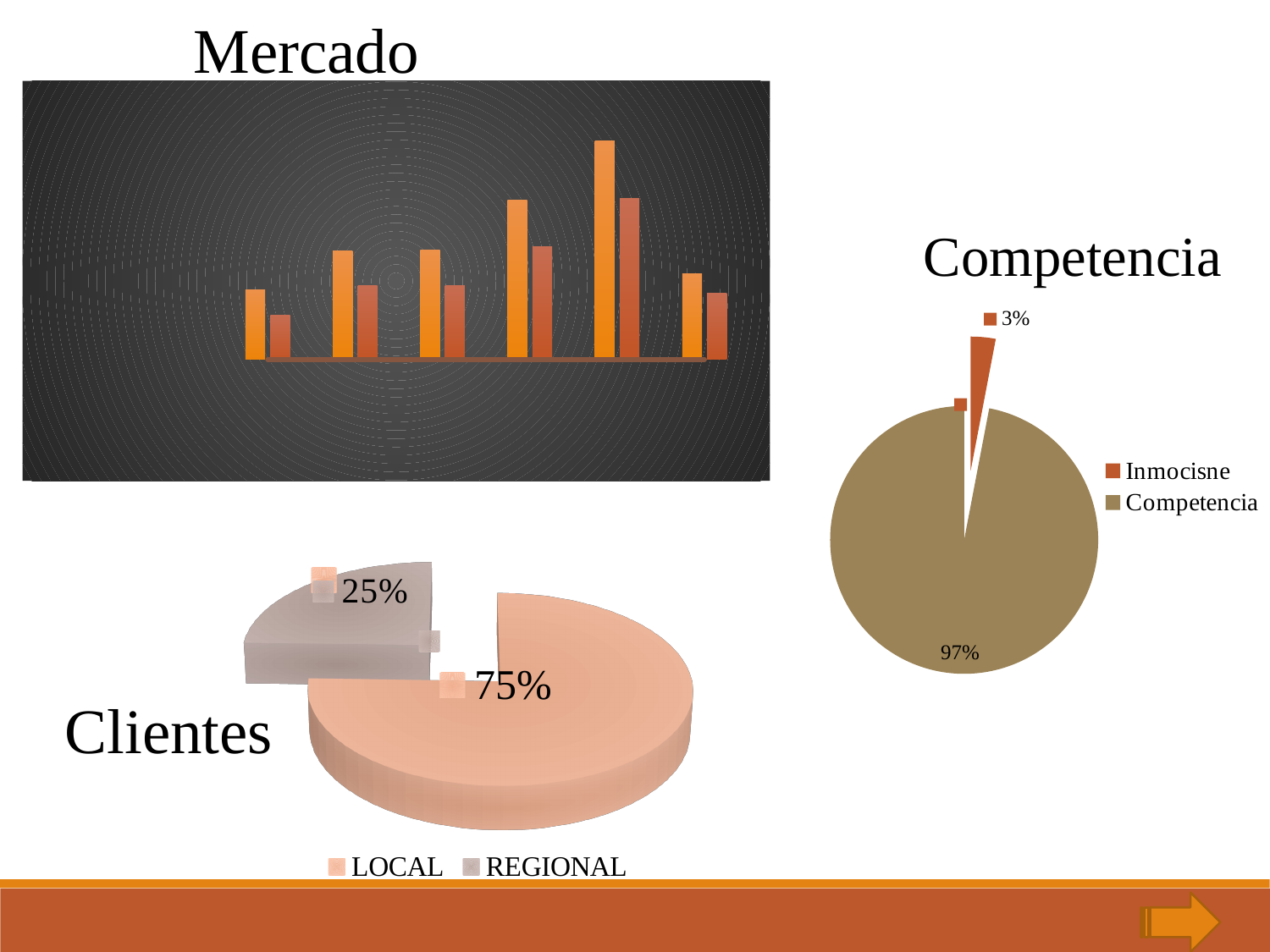
In the Competencia chart, what is the difference between the Competencia and Inmocisne shares? 94% In the Clientes chart, which is larger, LOCAL or REGIONAL? LOCAL In the Competencia chart, what share does Inmocisne have? 3% In the Clientes chart, what share is LOCAL? 75% In the Clientes chart, what is the difference between the LOCAL and REGIONAL shares? 50% What kind of chart is the Mercado chart? Bar chart In the Clientes chart, what share is REGIONAL? 25% In the Mercado chart, how many groups of bars are shown? 6 In the Competencia chart, how many entries does the legend list? 2 In the Competencia chart, which slice is the smallest? Inmocisne In the Competencia chart, what share does Competencia have? 97% In the Competencia chart, which slice is the largest? Competencia